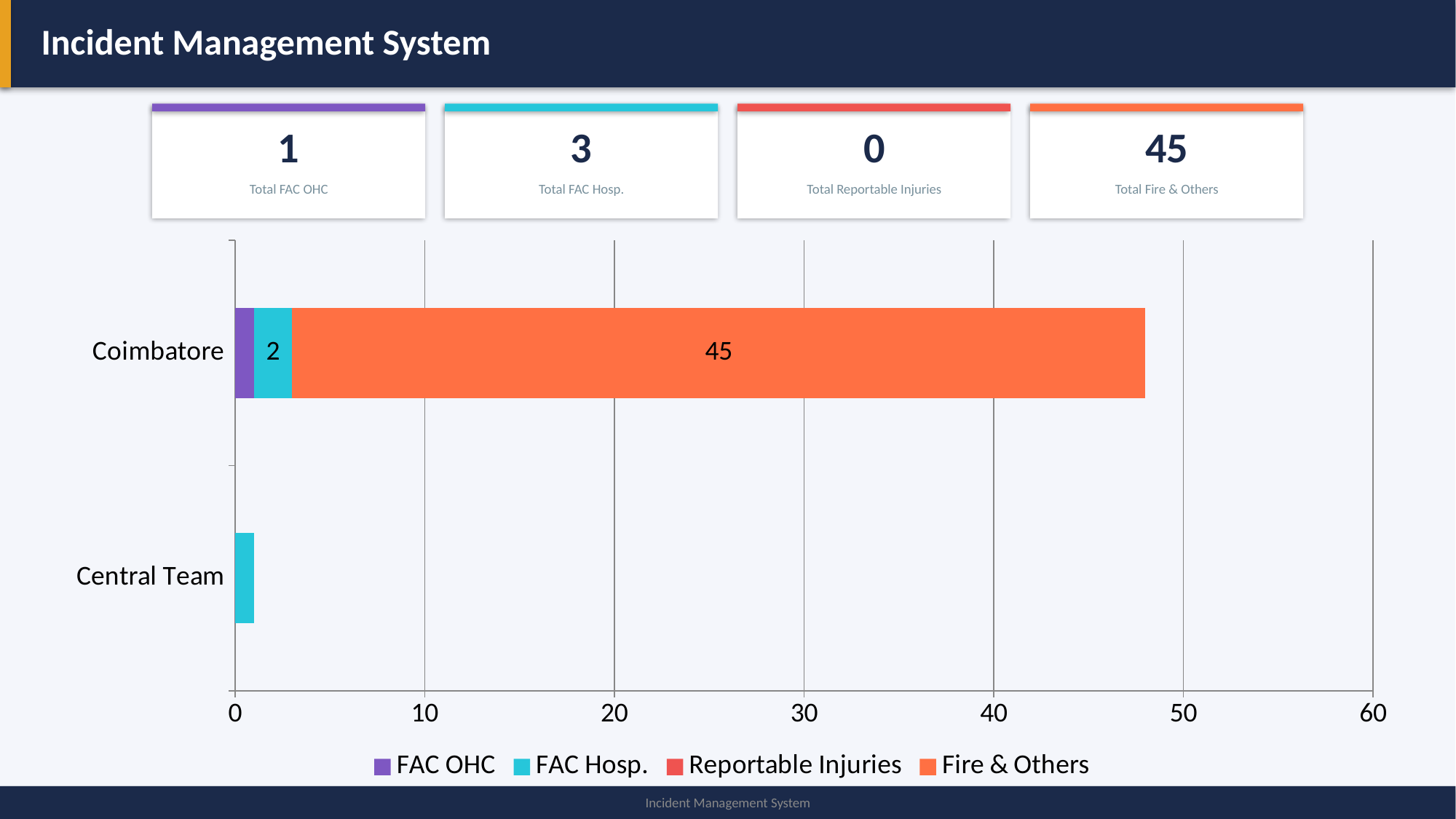
What is the FAC Hosp. value for Coimbatore? 2 How many series does the chart legend list? 4 What kind of chart is shown on the slide? Stacked bar chart Which colour represents the Fire & Others series in the legend? Orange Is the total bar length for Coimbatore greater or less than 40? greater Which category has the longer total bar, Coimbatore or Central Team? Coimbatore Is the total bar length for Central Team greater or less than 10? less How many categories are shown on the chart's vertical axis? 2 For Coimbatore, which is larger: the Fire & Others value or the FAC Hosp. value? Fire & Others Which category has the shorter total bar? Central Team What is the difference between the Fire & Others value and the FAC Hosp. value for Coimbatore? 43 What is the Fire & Others value for Coimbatore? 45